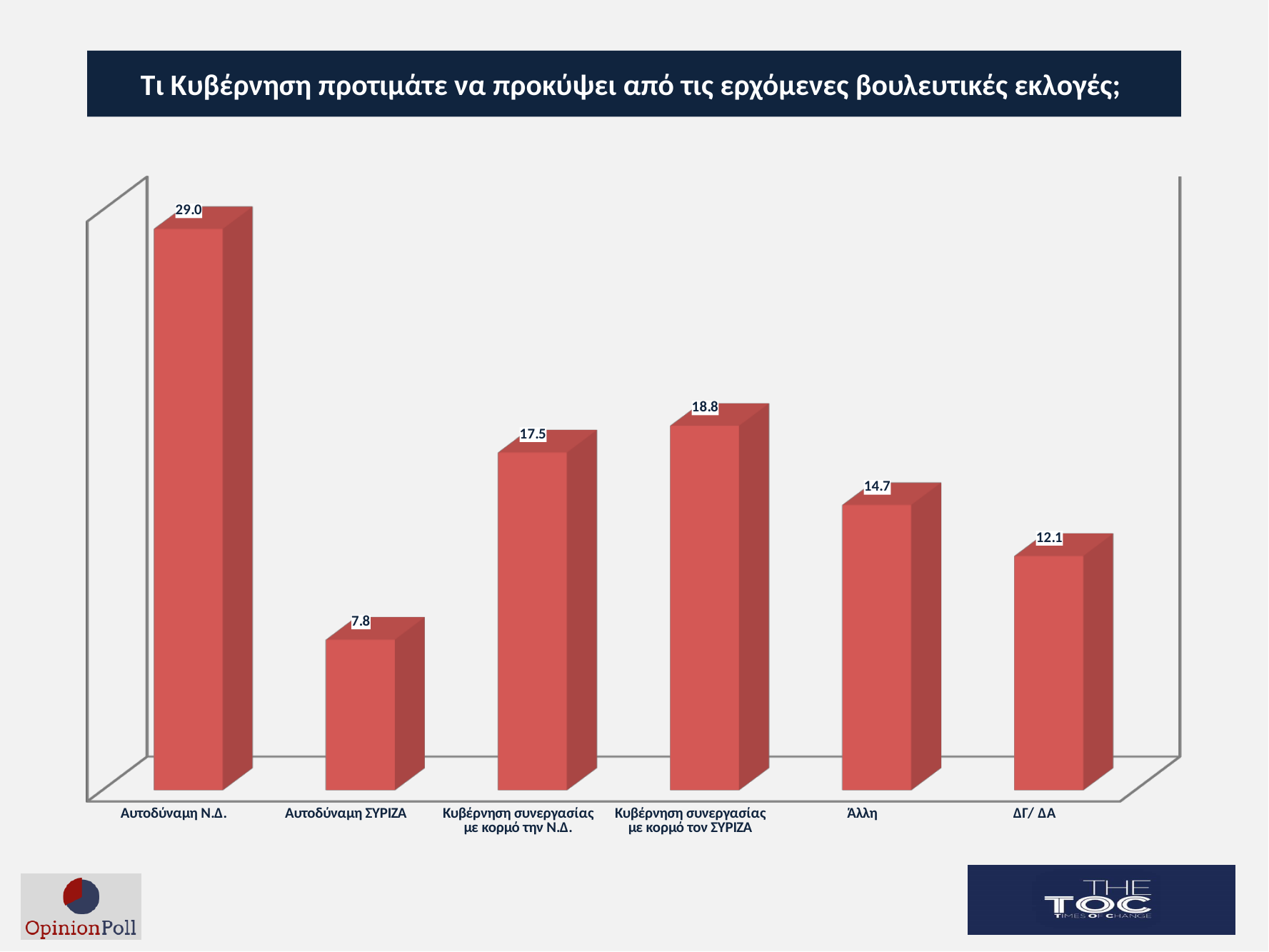
Which is larger, the value for Άλλη or the value for ΔΓ/ ΔΑ? Άλλη What kind of chart is shown on the slide? Bar chart What is the value for Κυβέρνηση συνεργασίας με κορμό την Ν.Δ.? 17.5 Which category has the highest value? Αυτοδύναμη Ν.Δ. What is the title of the chart? Τι Κυβέρνηση προτιμάτε να προκύψει από τις ερχόμενες βουλευτικές εκλογές; What is the value for Αυτοδύναμη Ν.Δ.? 29.0 What is the value for ΔΓ/ ΔΑ? 12.1 What is the value for Αυτοδύναμη ΣΥΡΙΖΑ? 7.8 What is the difference between the values for Κυβέρνηση συνεργασίας με κορμό τον ΣΥΡΙΖΑ and Κυβέρνηση συνεργασίας με κορμό την Ν.Δ.? 1.3 How many categories are shown in the chart? 6 Which category has the lowest value? Αυτοδύναμη ΣΥΡΙΖΑ What is the difference between the values for Αυτοδύναμη Ν.Δ. and Αυτοδύναμη ΣΥΡΙΖΑ? 21.2